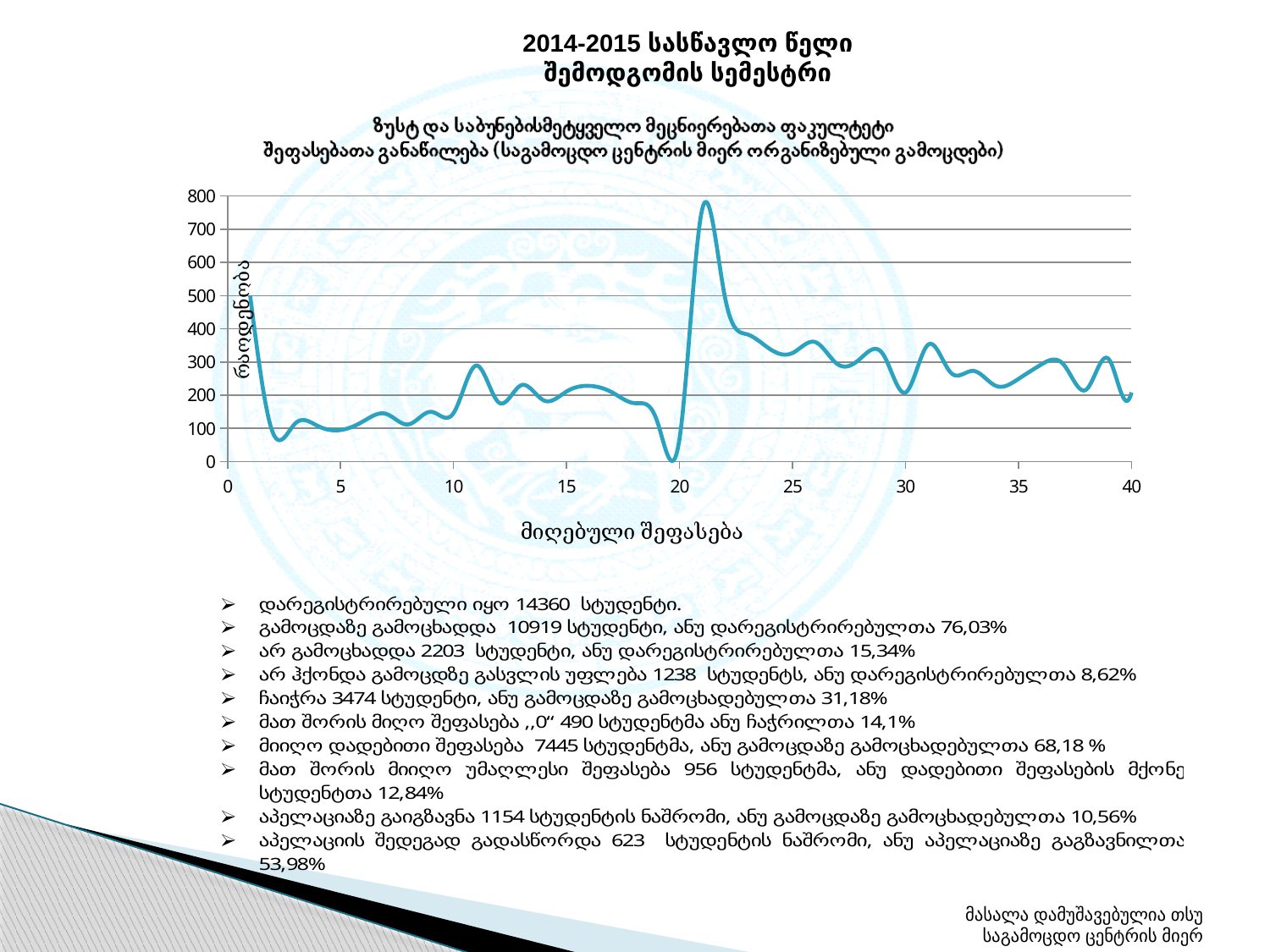
Which is larger: the value of the line at x = 21 or at x = 11? x = 21 Is the value of the line at x = 35 greater or less than 300? less Which is larger: the value of the line at x = 2 or at x = 25? x = 25 Does the line rise or fall overall between x = 21 and x = 30? fall What is the label of the y axis of the chart? რაოდენობა Is the value of the line at x = 10 greater or less than 200? less Is the value of the line at x = 2 greater or less than 100? less What is the label of the x axis of the chart? მიღებული შეფასება Around which x value does the line reach its highest point? 21 What kind of chart is shown on the slide? line chart